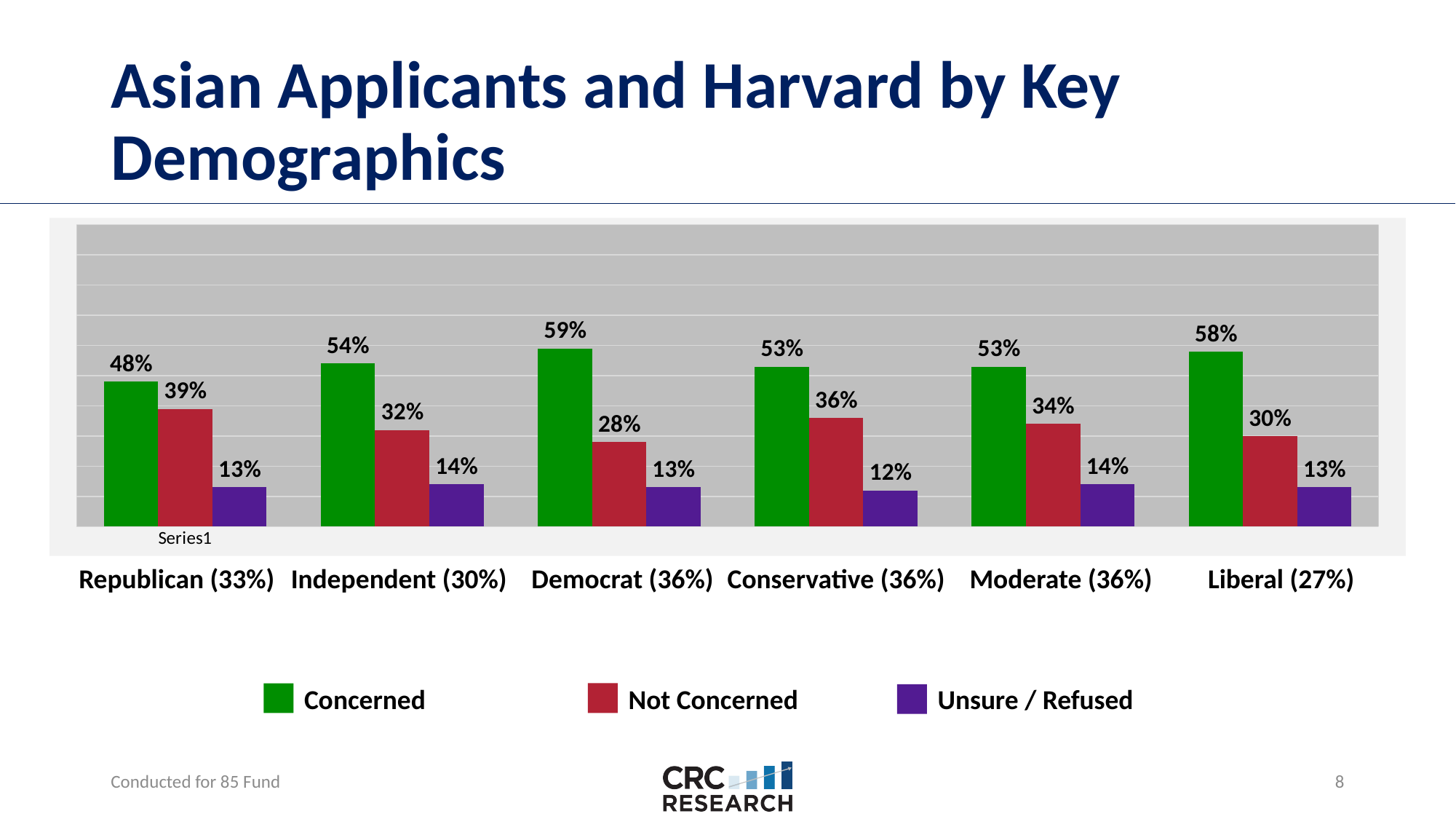
What is the difference between the Concerned and Not Concerned values for Liberals? 28% What percentage of Democrats are Concerned? 59% Which is larger, the Concerned value for Independents or the Concerned value for Moderates? Independents Which group has the highest Concerned value? Democrat (36%) What is the difference between the Not Concerned values for Republicans and Democrats? 11% How many series does the legend list? 3 Which colour represents the Unsure / Refused series? Purple Which group has the lowest Not Concerned value? Democrat (36%) What is the Unsure / Refused value for Conservatives? 12% What kind of chart is shown on the slide? Bar chart What is the Not Concerned value for Republicans? 39% How many demographic groups are shown on the chart? 6